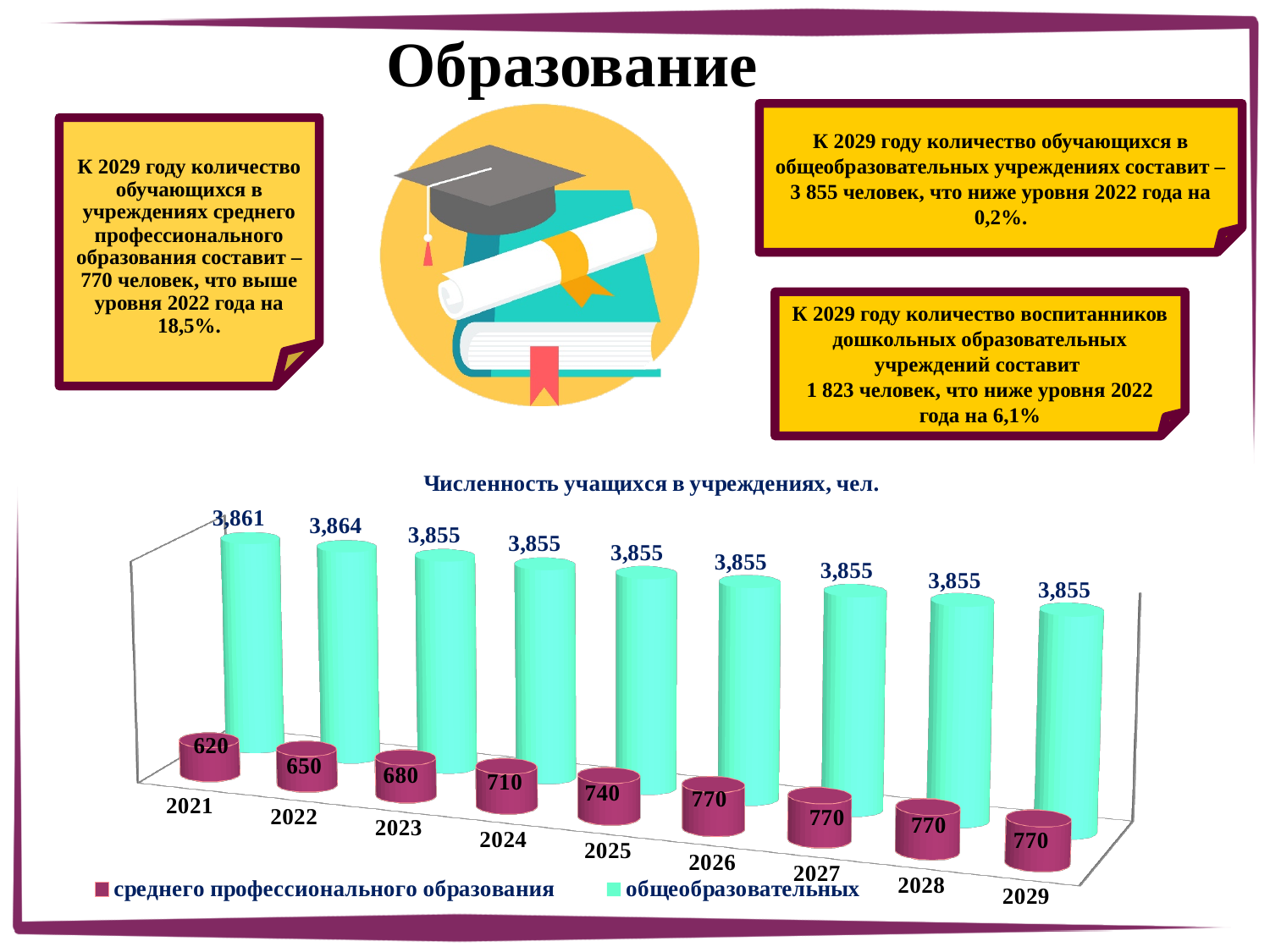
Which is larger in 2023: the value for общеобразовательных or for среднего профессионального образования? общеобразовательных In which year is the value for общеобразовательных the highest? 2022 What is the value for общеобразовательных in 2022? 3,864 In which year is the value for среднего профессионального образования the lowest? 2021 What is the difference between the среднего профессионального образования values for 2029 and 2021? 150 What is the value for среднего профессионального образования in 2021? 620 How many series does the chart legend list? 2 How many years are shown on the x axis of the chart? 9 Does the value for среднего профессионального образования rise or fall from 2021 to 2026? rise What is the value for среднего профессионального образования in 2024? 710 What kind of chart is shown on the slide? bar chart What is the difference between the общеобразовательных values for 2022 and 2029? 9